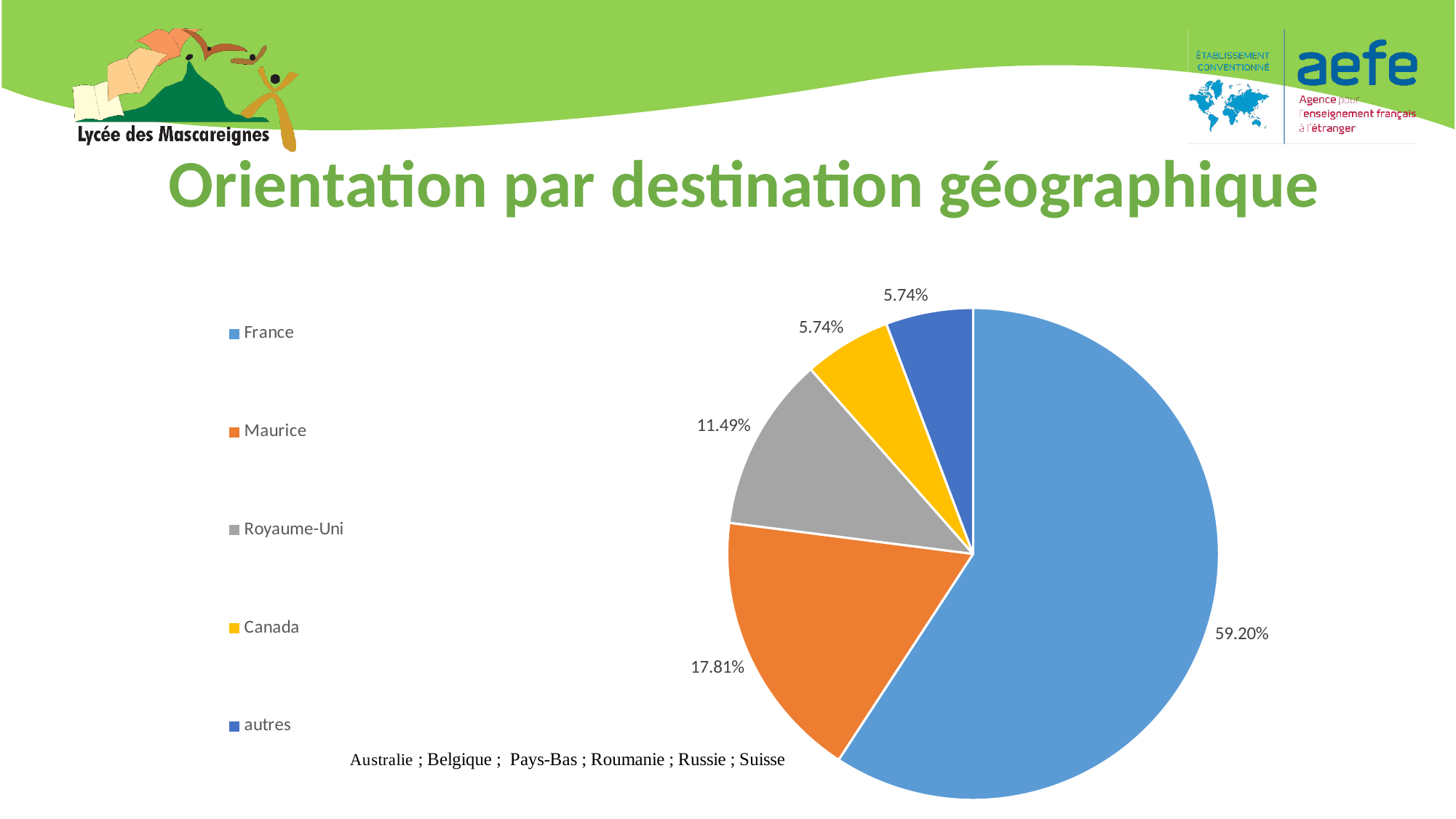
What is the value shown for Maurice? 17.81% What is the difference in percentage points between Maurice and Royaume-Uni? 6.32 What percentage is shown for Royaume-Uni? 11.49% How many slices does the pie chart have? 5 Which colour is used for the Canada slice in the pie chart? yellow Which is larger, the share for Maurice or the share for Royaume-Uni? Maurice What type of chart is shown on the slide? pie chart What is the difference in percentage points between France and Maurice? 41.39 What is the title of the slide containing the chart? Orientation par destination géographique What is the value shown for Canada? 5.74% What share of the pie does France represent? 59.20% Which destination has the largest slice of the pie? France